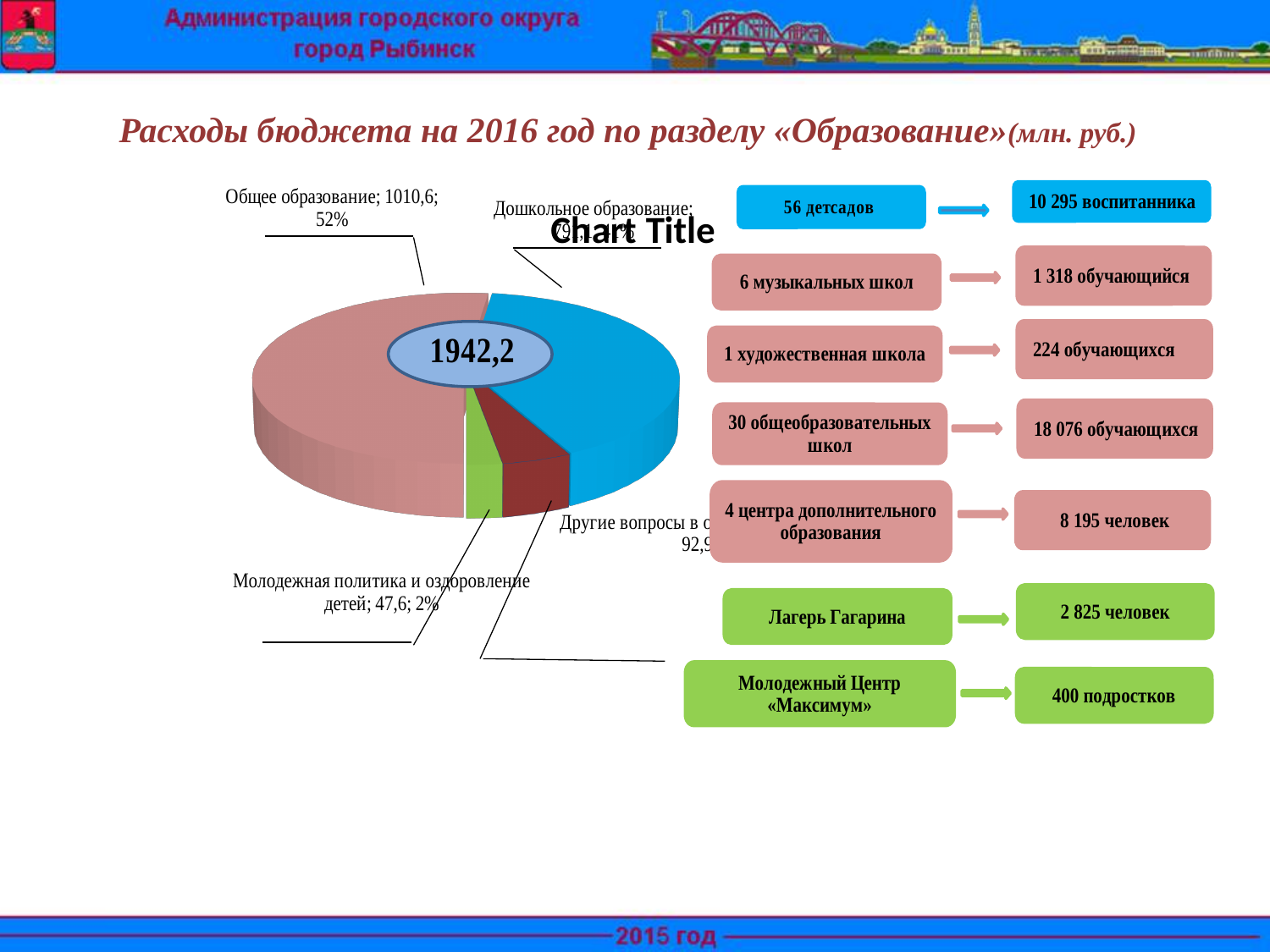
How many slices does the pie chart have? 4 Which category has the smallest slice in the pie chart? Молодежная политика и оздоровление детей What share of the pie does Молодежная политика и оздоровление детей represent? 2% What is the value for Молодежная политика и оздоровление детей in the pie chart? 47,6 Which is larger in the pie chart: Общее образование or Дошкольное образование? Общее образование What title is printed above the pie chart? Chart Title What is the difference between the values for Общее образование and Молодежная политика и оздоровление детей? 963,0 What kind of chart is shown on the slide? pie chart What number is shown in the oval at the centre of the pie chart? 1942,2 What share of the pie does Общее образование represent? 52% What is the value for Общее образование in the pie chart? 1010,6 Which category has the largest slice in the pie chart? Общее образование